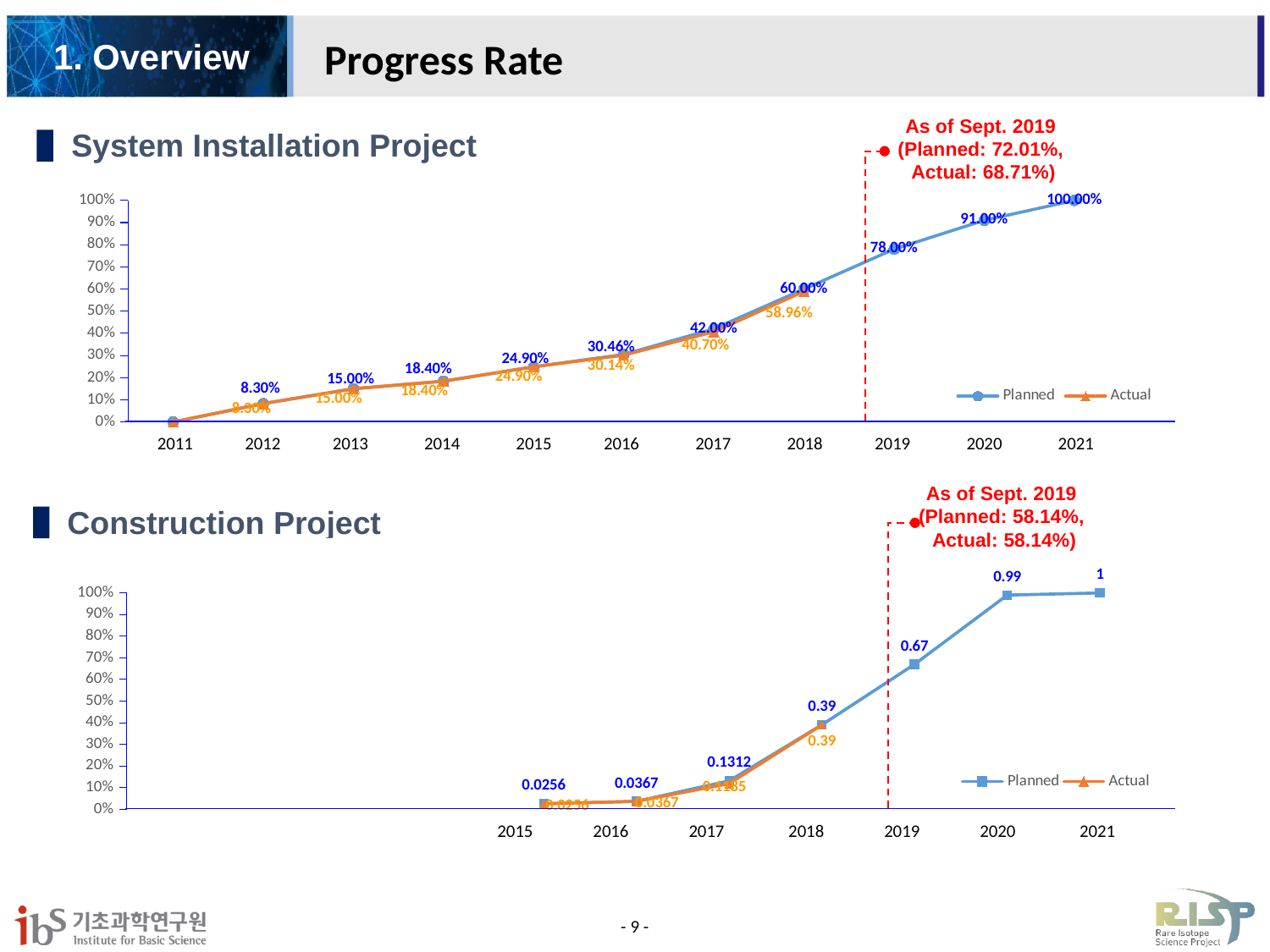
In the System Installation Project chart, what is the Planned value for 2018? 60.00% In the System Installation Project chart, which year has the highest Planned value? 2021 What kind of chart is the Construction Project chart? Line chart In the Construction Project chart, do the Planned values rise or fall from 2015 to 2021? Rise In the System Installation Project chart, what is the Planned value for 2020? 91.00% In the System Installation Project chart, what is the difference between the Planned and Actual values for 2017? 1.30% How many years are shown on the x axis of the Construction Project chart? 7 How many series does the legend of the System Installation Project chart list? 2 In the System Installation Project chart, what is the Actual value for 2018? 58.96% In the Construction Project chart, what is the Planned value for 2017? 0.1312 In the System Installation Project chart, what is the Actual value for 2016? 30.14% In the Construction Project chart, what is the Planned value for 2019? 0.67